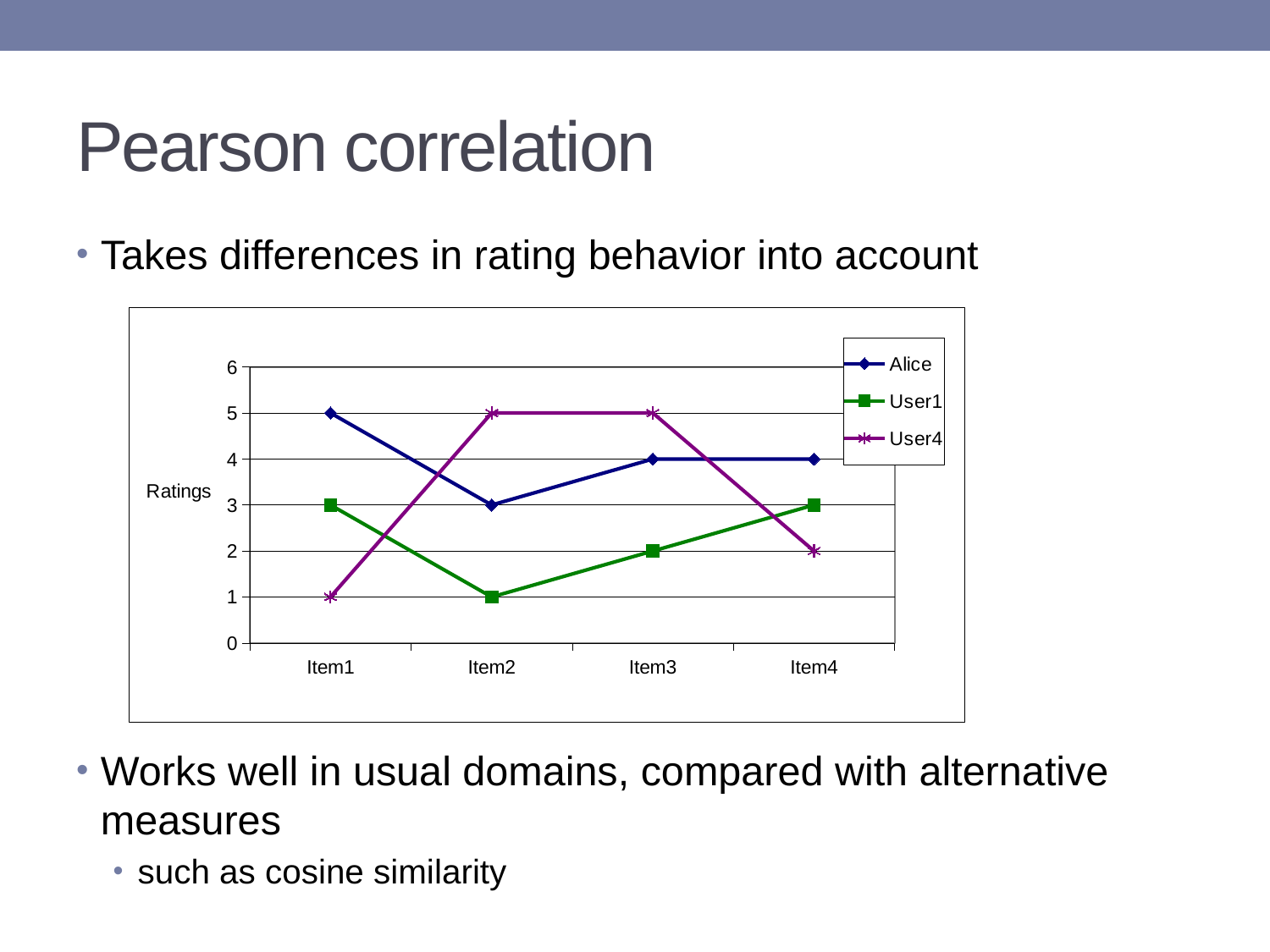
What is the difference between Alice's and User1's ratings for Item3? 2 What is User4's rating for Item4? 2 What is Alice's rating for Item1? 5 What is User1's rating for Item2? 1 Does User1's rating rise or fall from Item2 to Item4? Rise What is the label of the y axis? Ratings For which item is User4's rating lowest? Item1 How many series does the legend list? 3 For which item is Alice's rating highest? Item1 Which is larger for Item2: Alice's rating or User4's rating? User4 What kind of chart is shown on the slide? Line chart How many items are shown on the x axis? 4